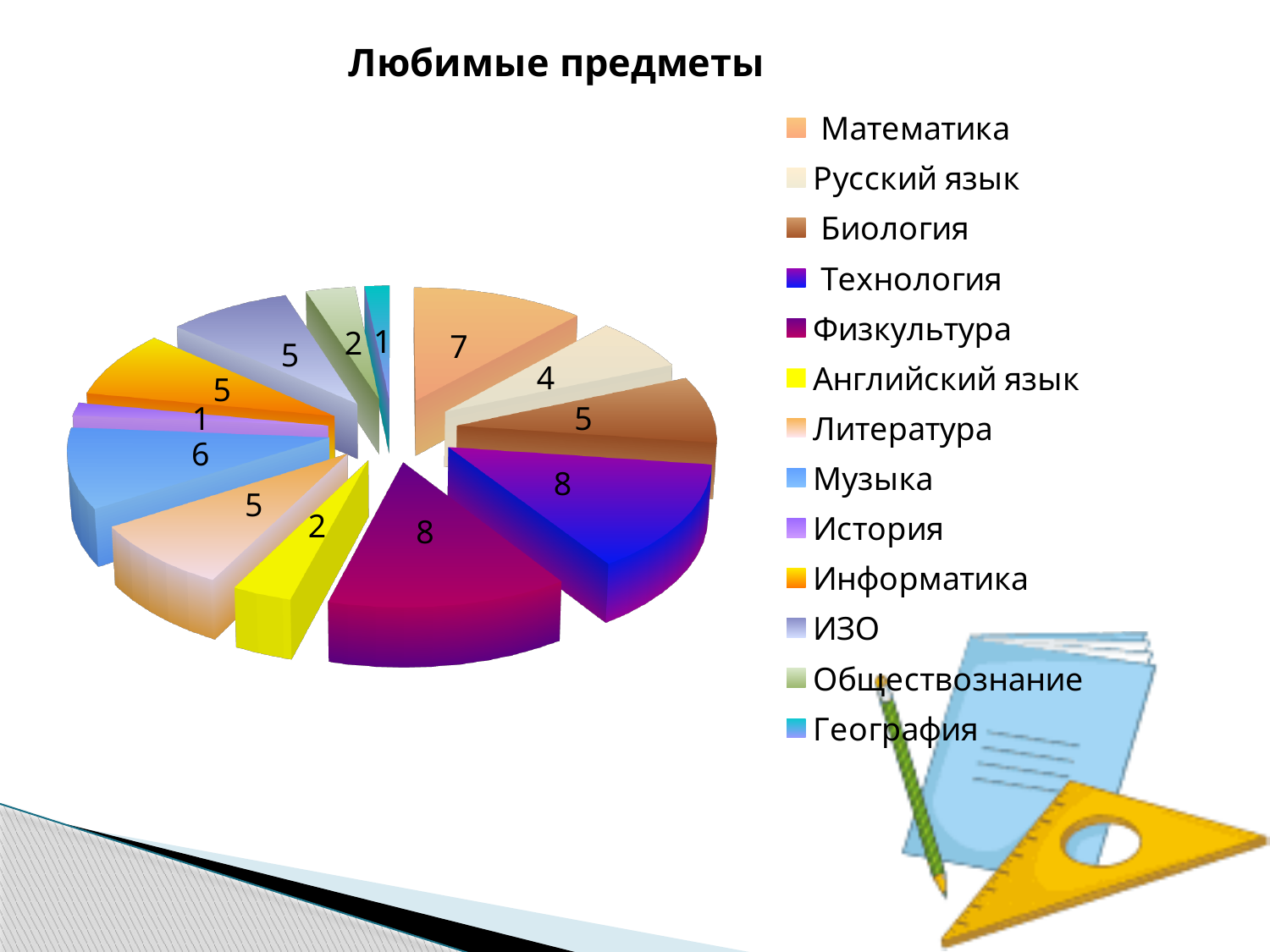
What is the value for Музыка? 6 What is the difference between the values for Физкультура and Литература? 3 What is the value for Английский язык? 2 What is the value for Технология? 8 How many categories (subjects) does the pie chart show? 13 Which legend entry is shown in yellow? Английский язык What kind of chart is shown on the slide? pie chart What is the value for География? 1 What is the value for Математика? 7 What is the value for Русский язык? 4 What is the title of the chart? Любимые предметы Which has a larger value, Математика or Музыка? Математика